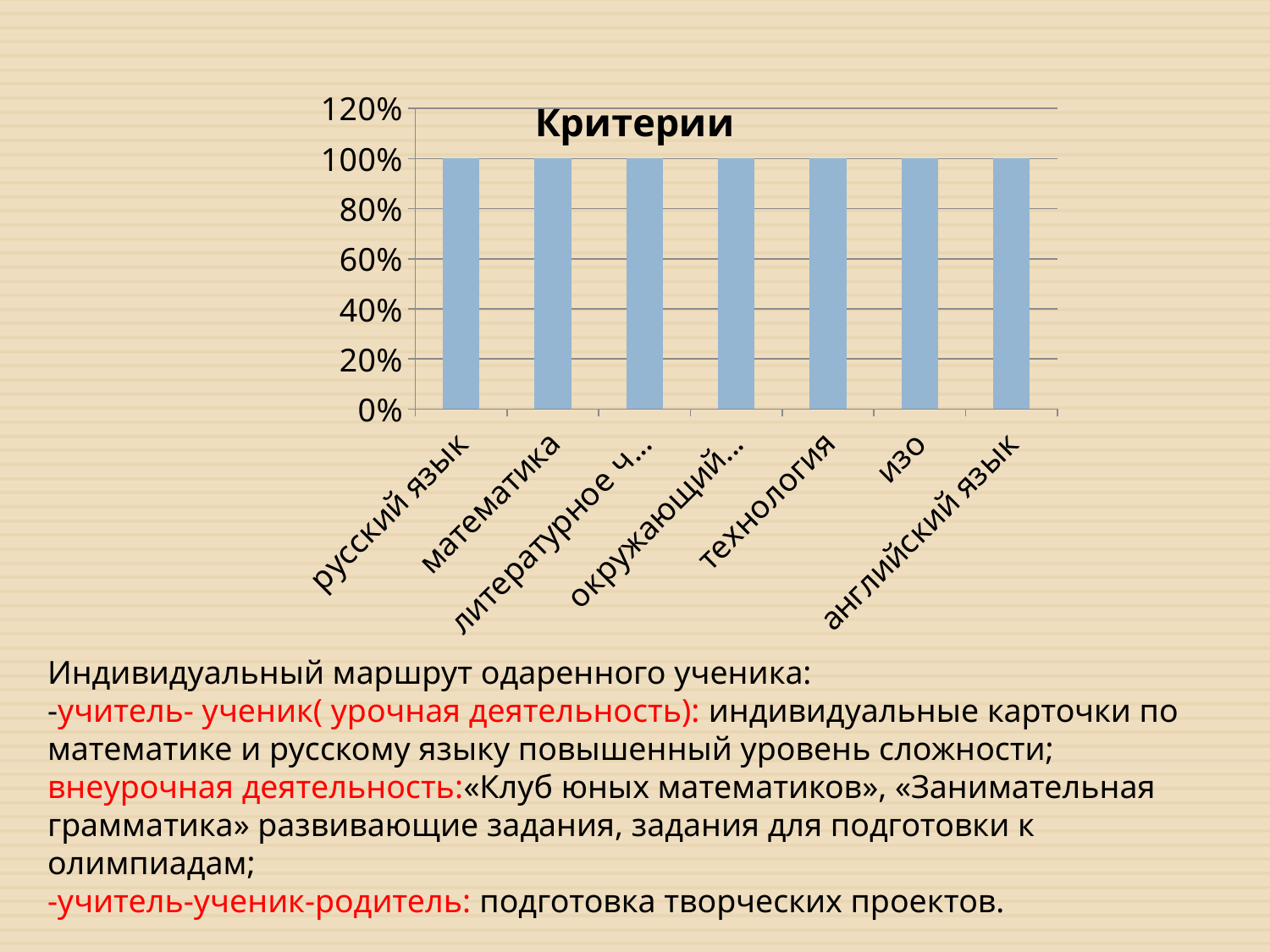
What is the value for технология? 100% What is the difference between the values for русский язык and английский язык? 0% Do the values rise, fall, or stay the same across the categories along the x axis? stay the same Is the value for математика greater or less than 80%? greater What is the value for английский язык? 100% What is the value for изо? 100% What is the title of the chart? Критерии What is the value for русский язык? 100% How many categories (bars) does the chart show? 7 What is the value for математика? 100% What is the highest value shown on the vertical axis? 120% What type of chart is shown on the slide? bar chart